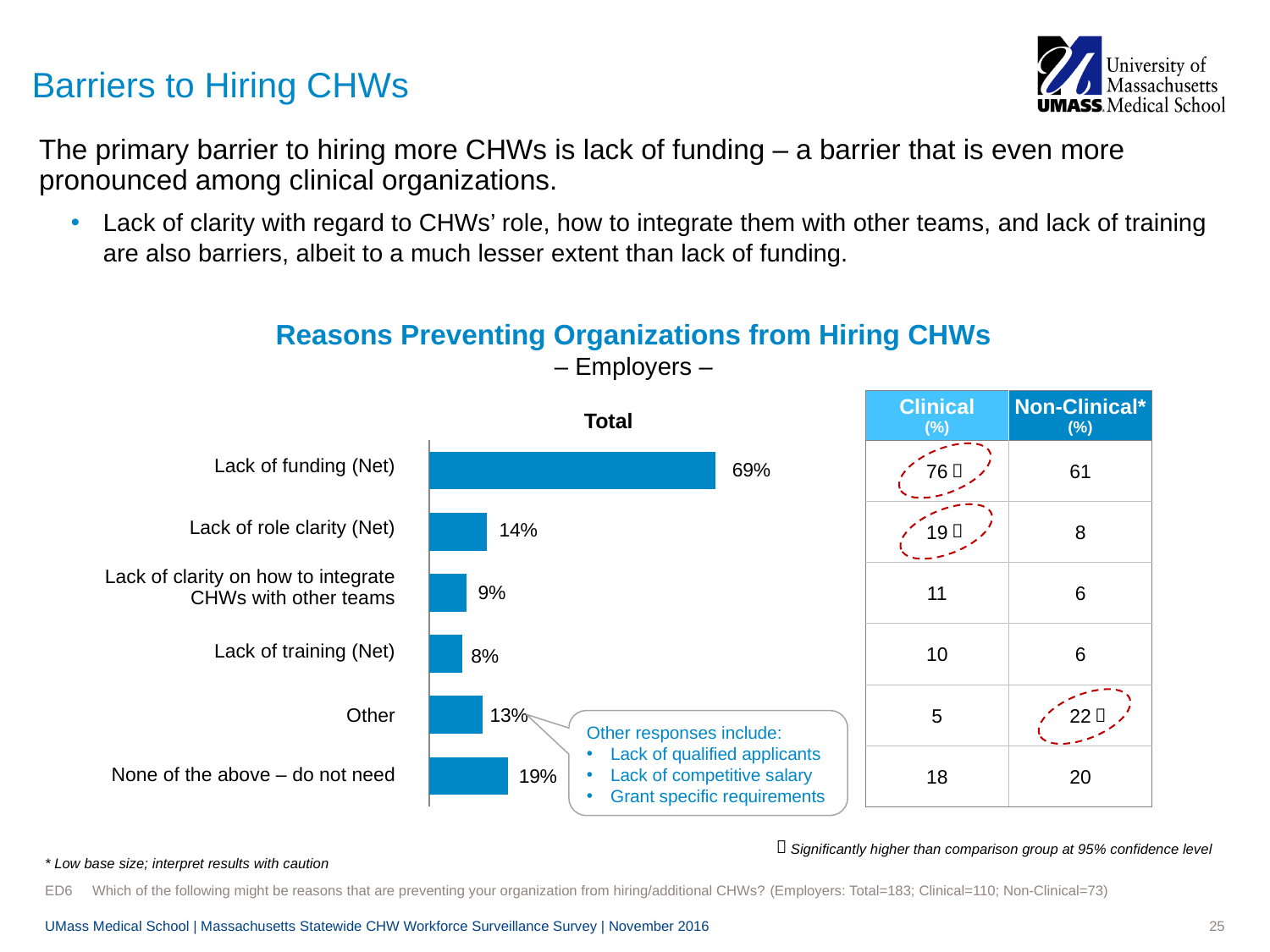
Which category has the lowest Total value? Lack of training (Net) Which has a larger Total value: Other or Lack of clarity on how to integrate CHWs with other teams? Other What kind of chart is used to show the Total values? Bar chart Which category has the highest Total value? Lack of funding (Net) What is the Total value for Lack of role clarity (Net)? 14% What is the difference between the Total values for None of the above – do not need and Other? 6% What is the title of the chart? Reasons Preventing Organizations from Hiring CHWs – Employers – How many categories are shown in the bar chart? 6 What is the Total value for Lack of training (Net)? 8% What is the difference between the Total values for Lack of funding (Net) and Lack of role clarity (Net)? 55% What is the Total value for Lack of funding (Net)? 69% What is the Total value for None of the above – do not need? 19%